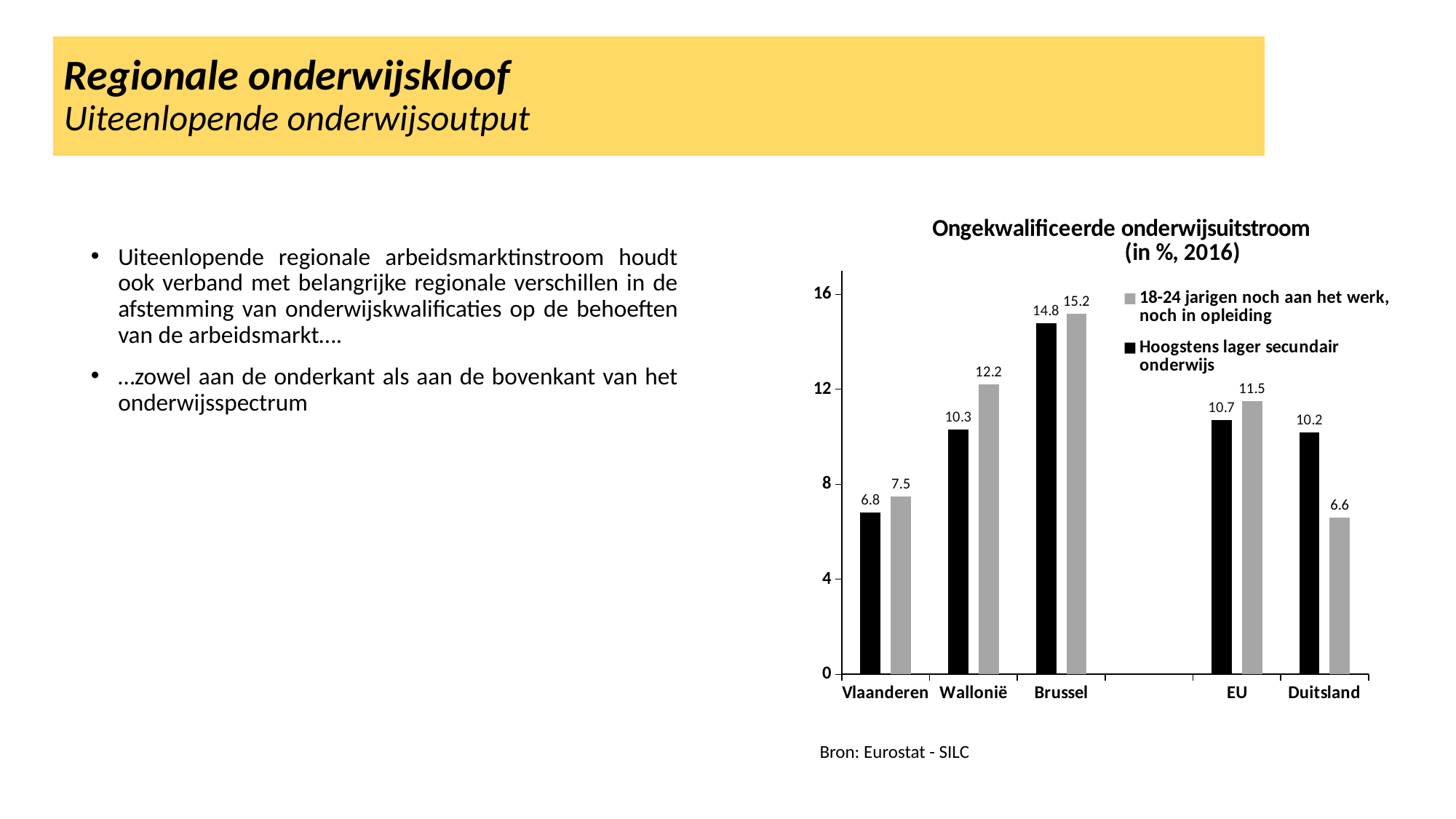
Is the value for EU in the 'Hoogstens lager secundair onderwijs' series greater or less than 12? less Which category has the lowest value in the 'Hoogstens lager secundair onderwijs' series? Vlaanderen For Duitsland, which series has the larger value: 'Hoogstens lager secundair onderwijs' or '18-24 jarigen noch aan het werk, noch in opleiding'? Hoogstens lager secundair onderwijs What kind of chart is shown on the slide? bar chart What is the value for Brussel in the 'Hoogstens lager secundair onderwijs' series? 14.8 What is the title of the chart? Ongekwalificeerde onderwijsuitstroom (in %, 2016) Which category has the highest value in the '18-24 jarigen noch aan het werk, noch in opleiding' series? Brussel What is the value for Wallonië in the 'Hoogstens lager secundair onderwijs' series? 10.3 How many categories are shown on the x axis? 5 How many series does the legend list? 2 What is the difference between the two series values for Wallonië? 1.9 What is the value for Duitsland in the '18-24 jarigen noch aan het werk, noch in opleiding' series? 6.6